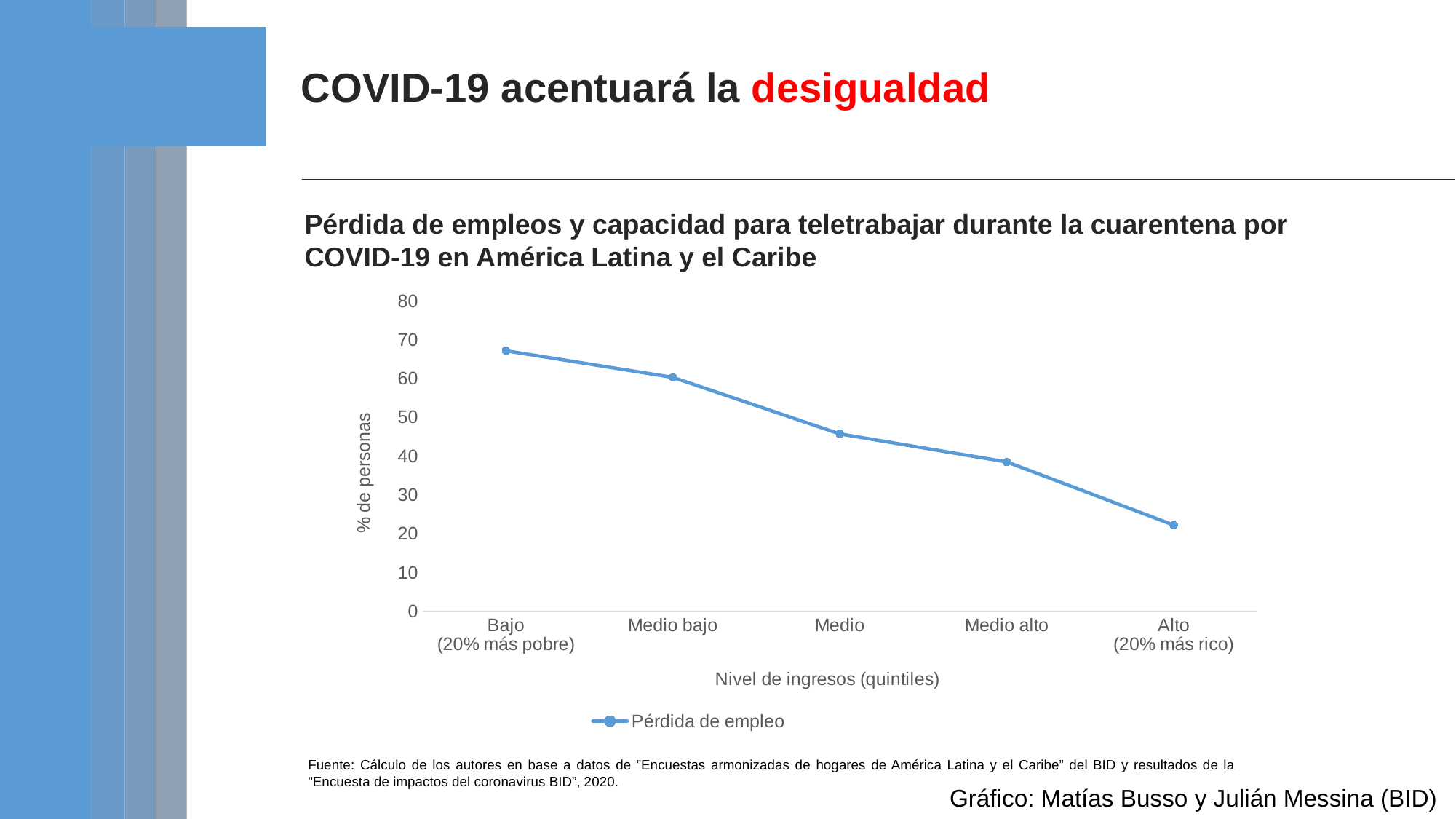
Which income quintile has the lowest value for Pérdida de empleo? Alto (20% más rico) How many income quintiles are plotted on the x axis? 5 Do the values rise or fall as income level moves from Bajo to Alto? fall Is the value for Medio greater or less than 50? less Which income quintile has the highest value for Pérdida de empleo? Bajo (20% más pobre) Which has a larger value for Pérdida de empleo, Bajo (20% más pobre) or Alto (20% más rico)? Bajo (20% más pobre) How many series does the legend list? 1 What series name is shown in the legend? Pérdida de empleo Is the value for Alto (20% más rico) greater or less than 30? less What kind of chart is shown on the slide? line chart Is the value for Bajo (20% más pobre) greater or less than 60? greater What is the label of the y axis? % de personas